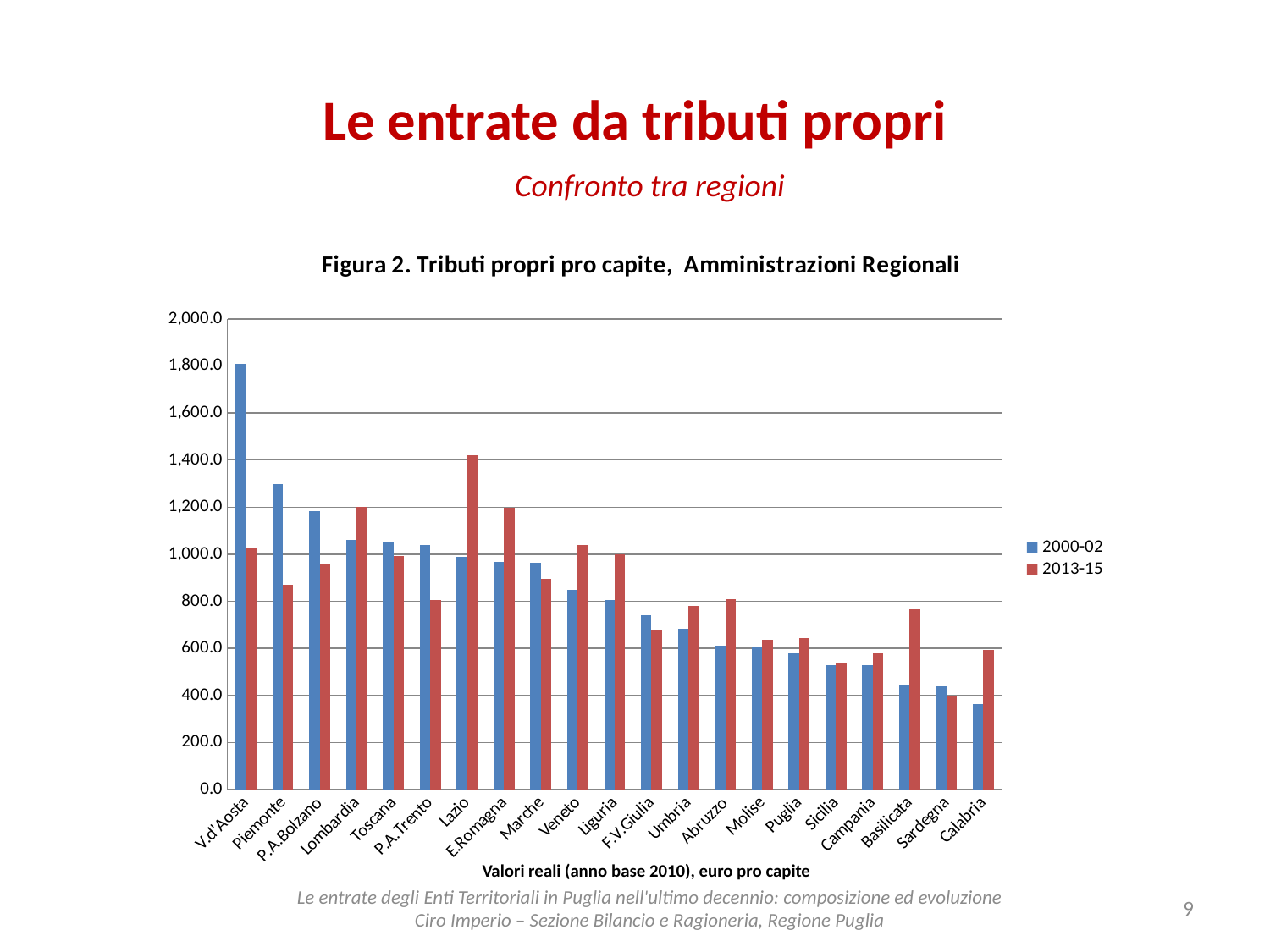
How many series does the legend list? 2 Is the 2000-02 value for V.d'Aosta greater or less than 1,600? greater Which region has the lowest value for the 2000-02 series? Calabria Is the 2013-15 value for Basilicata greater or less than 600? greater Is the 2013-15 value for Lazio greater or less than 1,200? greater Which region has the highest value for the 2000-02 series? V.d'Aosta For Calabria, which series has the larger value, 2000-02 or 2013-15? 2013-15 For Piemonte, which series has the larger value, 2000-02 or 2013-15? 2000-02 What kind of chart is shown on the slide? bar chart How many regions are shown on the x axis? 21 Which region has the highest value for the 2013-15 series? Lazio